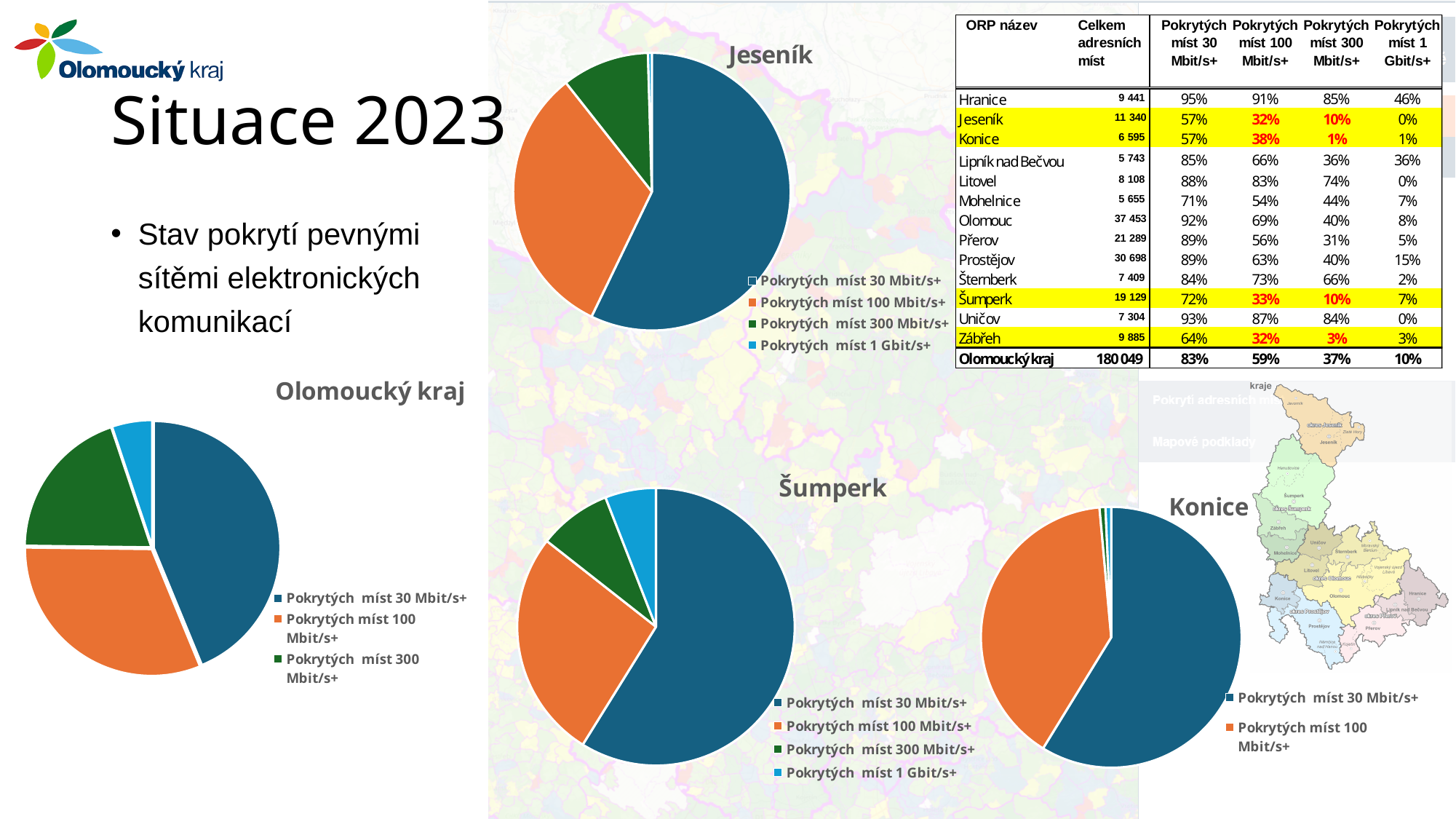
In the Jeseník chart, which category has the smallest slice? Pokrytých míst 1 Gbit/s+ In the Konice chart, how many entries does the legend list? 2 In the Šumperk chart, which category has the smallest slice? Pokrytých míst 1 Gbit/s+ In the Konice chart, which category has the largest slice? Pokrytých míst 30 Mbit/s+ In the Olomoucký kraj chart, how many entries does the legend list? 3 In the Šumperk chart, which category has the largest slice? Pokrytých míst 30 Mbit/s+ What kind of chart is used for the Jeseník chart? pie chart In the Olomoucký kraj chart, which slice is larger: Pokrytých míst 100 Mbit/s+ or Pokrytých míst 300 Mbit/s+? Pokrytých míst 100 Mbit/s+ In the Jeseník chart, how many entries does the legend list? 4 How many pie charts are shown on the slide? 4 In the Jeseník chart, which category has the largest slice? Pokrytých míst 30 Mbit/s+ In the Šumperk chart, what colour is the slice for Pokrytých míst 100 Mbit/s+? orange